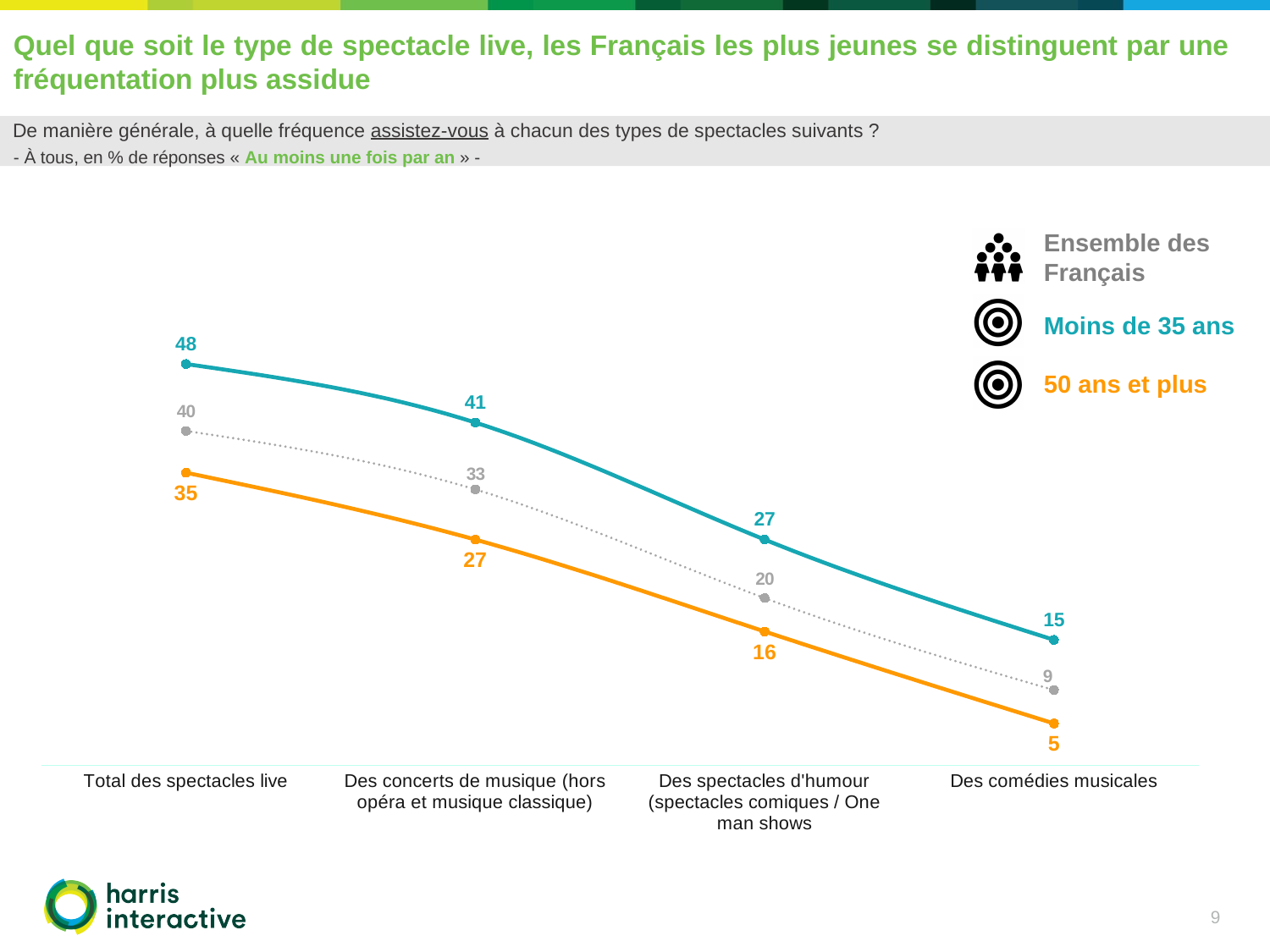
How many categories are shown on the x axis? 4 What value is shown for "50 ans et plus" for "Des spectacles d'humour (spectacles comiques / One man shows)"? 16 Which category has the highest value for "50 ans et plus"? Total des spectacles live Do the values for "Ensemble des Français" rise or fall from left to right along the x axis? Fall What value is shown for "Ensemble des Français" for "Des comédies musicales"? 9 What kind of chart is shown on the slide? Line chart What is the difference between the "Moins de 35 ans" and "50 ans et plus" values for "Des concerts de musique (hors opéra et musique classique)"? 14 Which category has the lowest value for "Moins de 35 ans"? Des comédies musicales What value is shown for "Ensemble des Français" for "Des concerts de musique (hors opéra et musique classique)"? 33 Which is larger for "Des comédies musicales": the value for "Moins de 35 ans" or for "50 ans et plus"? Moins de 35 ans What value is shown for "Moins de 35 ans" for "Total des spectacles live"? 48 How many series does the legend list? 3